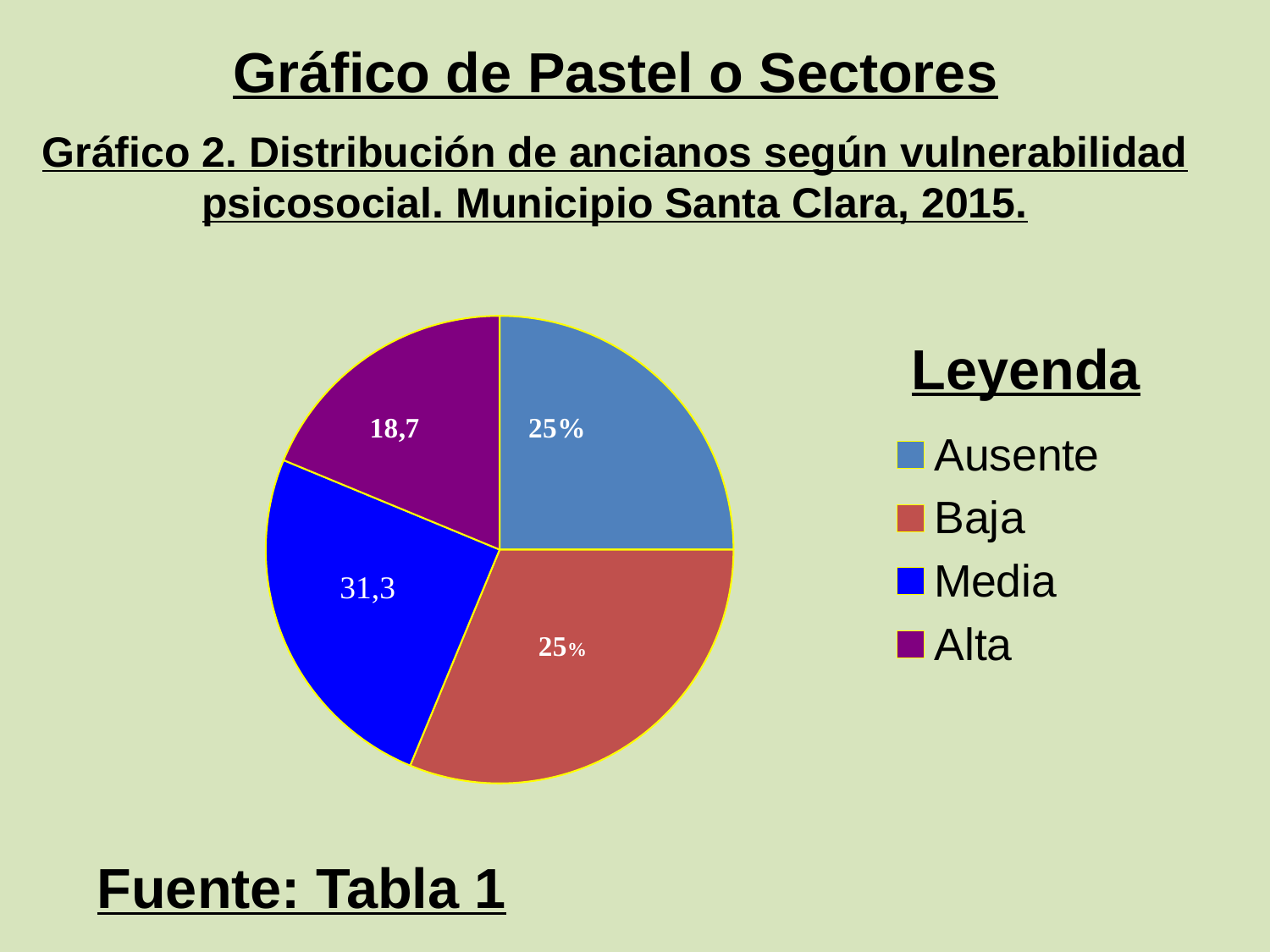
Which category has the smallest slice of the pie chart? Alta Which slice is larger, Media or Alta? Media What kind of chart is shown on the slide? Pie chart How many entries does the legend list? 4 What value is shown for the Alta slice of the pie chart? 18,7 What source is cited below the chart? Tabla 1 What value is shown for the Media slice of the pie chart? 31,3 What value is shown for the Baja slice of the pie chart? 25% How many slices does the pie chart have? 4 What value is shown for the Ausente slice of the pie chart? 25%